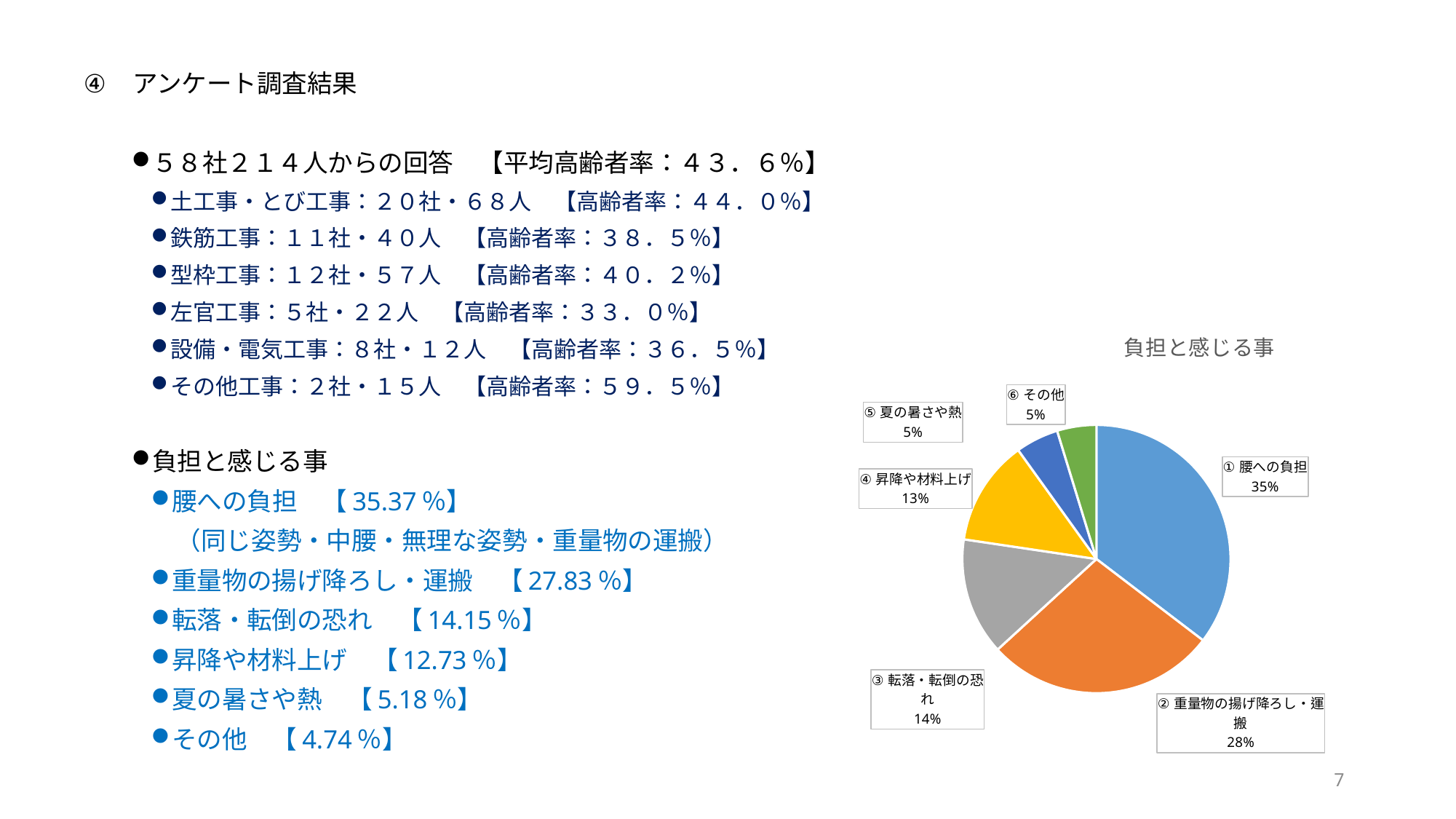
What share of the pie does ⑥ その他 represent? 5% What type of chart is shown on the slide? pie chart What percentage does the pie chart show for ② 重量物の揚げ降ろし・運搬? 28% What is the title of the pie chart? 負担と感じる事 What percentage does the pie chart show for ⑤ 夏の暑さや熱? 5% In the pie chart, which is larger: ② 重量物の揚げ降ろし・運搬 or ③ 転落・転倒の恐れ? ② 重量物の揚げ降ろし・運搬 What percentage does the pie chart show for ④ 昇降や材料上げ? 13% What is the difference in percentage points between ① 腰への負担 and ② 重量物の揚げ降ろし・運搬 in the pie chart? 7 How many slices does the pie chart have? 6 What percentage does the pie chart show for ① 腰への負担? 35% Which slice of the pie chart is the largest? ① 腰への負担 What percentage does the pie chart show for ③ 転落・転倒の恐れ? 14%